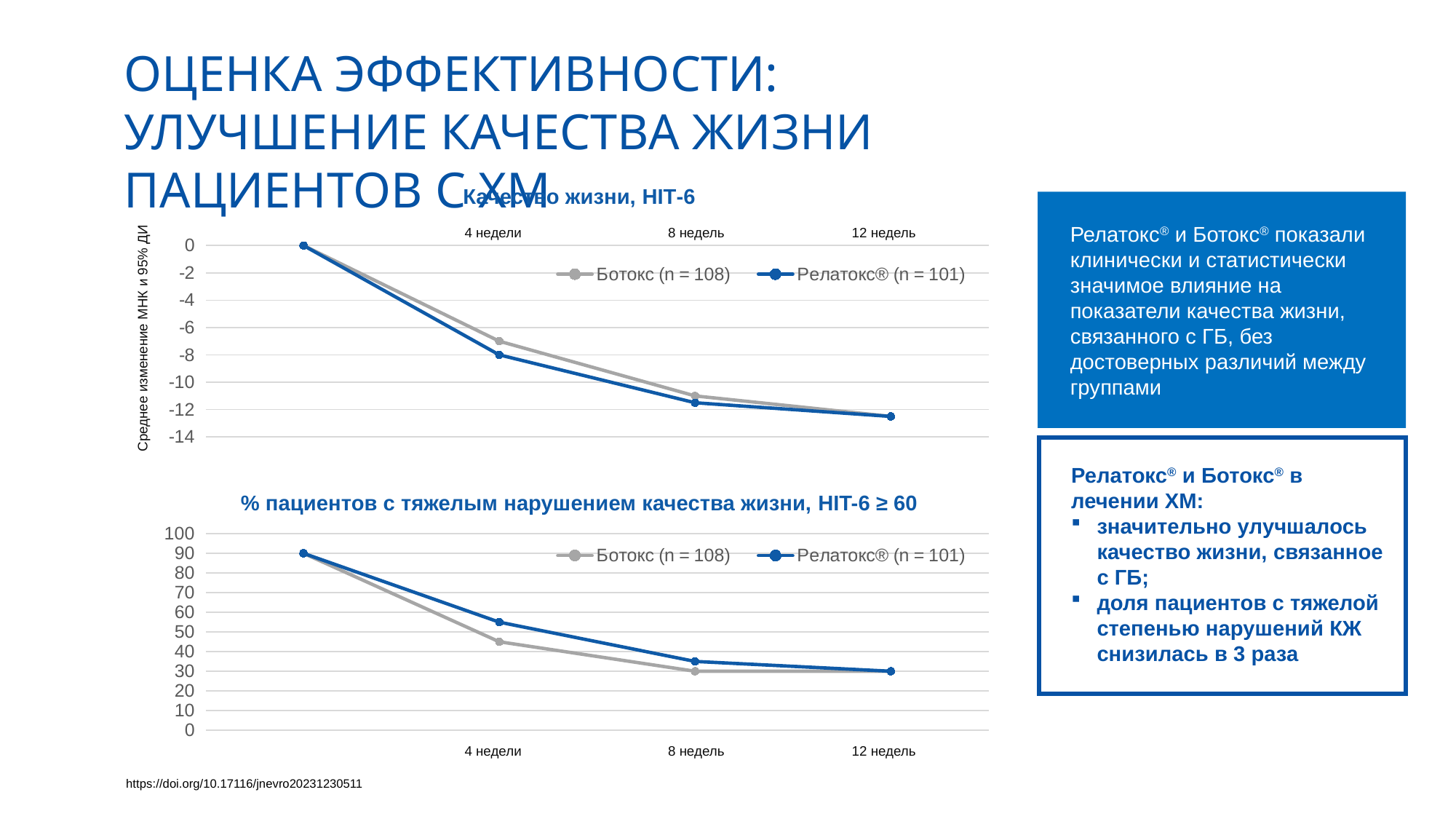
In the bottom chart '% пациентов с тяжелым нарушением качества жизни, HIT-6 ≥ 60', is the value for Релатокс® at 4 недели greater or less than 50? greater In the bottom chart '% пациентов с тяжелым нарушением качества жизни, HIT-6 ≥ 60', is the value for Ботокс at 4 недели greater or less than 50? less In the bottom chart '% пациентов с тяжелым нарушением качества жизни, HIT-6 ≥ 60', what is the value for Ботокс at 8 недель? 30 What type of chart is the top chart titled 'Качество жизни, HIT-6'? line chart In the bottom chart '% пациентов с тяжелым нарушением качества жизни, HIT-6 ≥ 60', which series has the higher value at 4 недели, Ботокс or Релатокс®? Релатокс® In the top chart 'Качество жизни, HIT-6', is the value for Ботокс at 12 недель greater or less than -10? less In the bottom chart '% пациентов с тяжелым нарушением качества жизни, HIT-6 ≥ 60', what is the value for Релатокс® at 12 недель? 30 In the bottom chart '% пациентов с тяжелым нарушением качества жизни, HIT-6 ≥ 60', do the values rise or fall over the weeks? fall What are the two legend entries shown in the top chart 'Качество жизни, HIT-6'? Ботокс (n = 108) and Релатокс® (n = 101) What is the y-axis title of the top chart 'Качество жизни, HIT-6'? Среднее изменение МНК и 95% ДИ How many series does the legend of the bottom chart '% пациентов с тяжелым нарушением качества жизни, HIT-6 ≥ 60' list? 2 In the top chart 'Качество жизни, HIT-6', do the values rise or fall from left to right along the x axis? fall